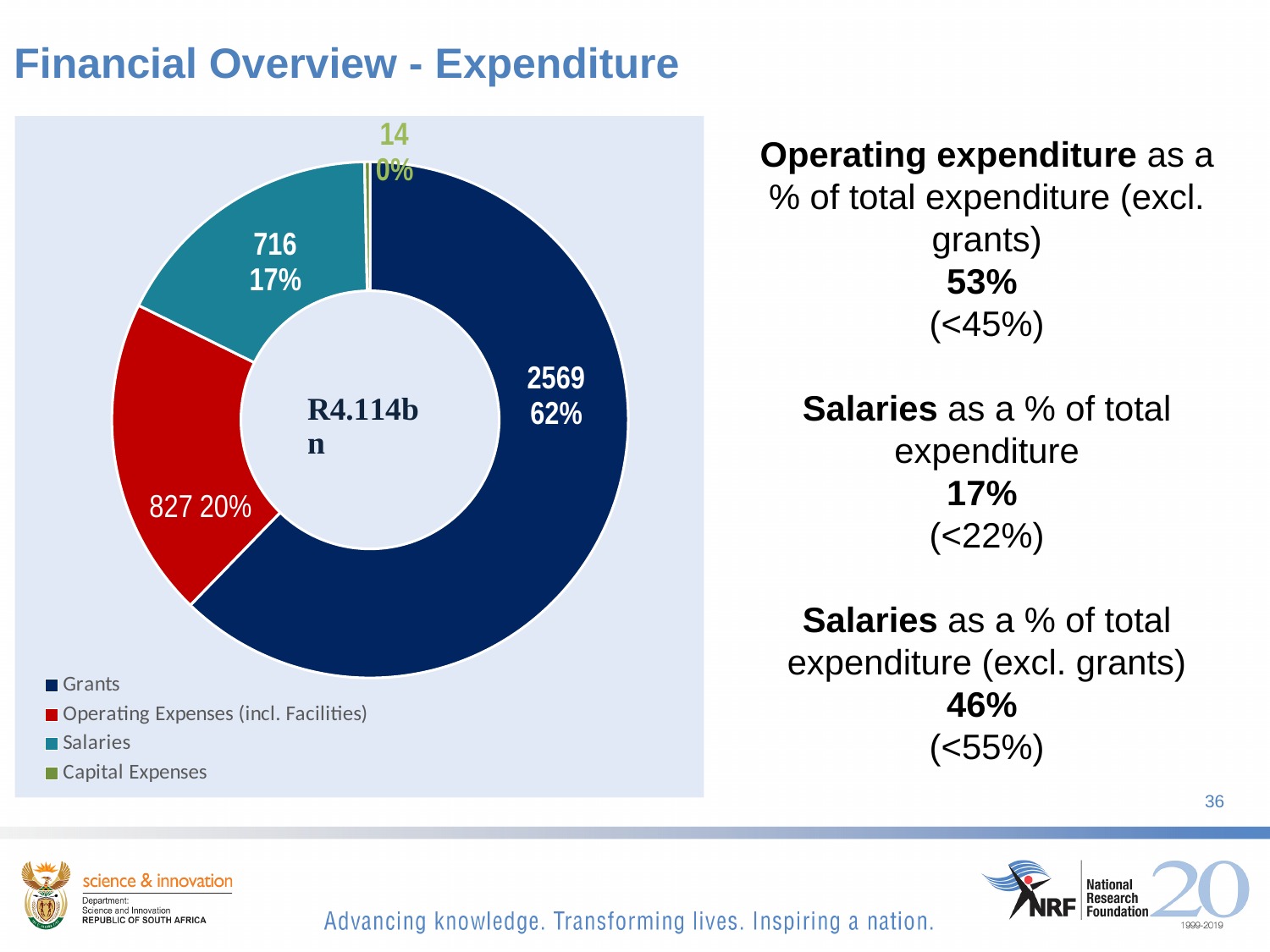
What is the value shown for Capital Expenses? 14 What is the value shown for Grants? 2569 What is the value shown for Operating Expenses (incl. Facilities)? 827 What is the value shown for Salaries? 716 Which category has the largest value? Grants How many categories does the legend list? 4 Which category has the smallest value? Capital Expenses What kind of chart is shown on the slide? Doughnut (pie) chart What percentage share of the chart does Salaries represent? 17% What percentage share of the chart does Grants represent? 62% Which is larger, the value for Operating Expenses (incl. Facilities) or the value for Salaries? Operating Expenses (incl. Facilities) What is the difference between the values for Grants and Operating Expenses (incl. Facilities)? 1742